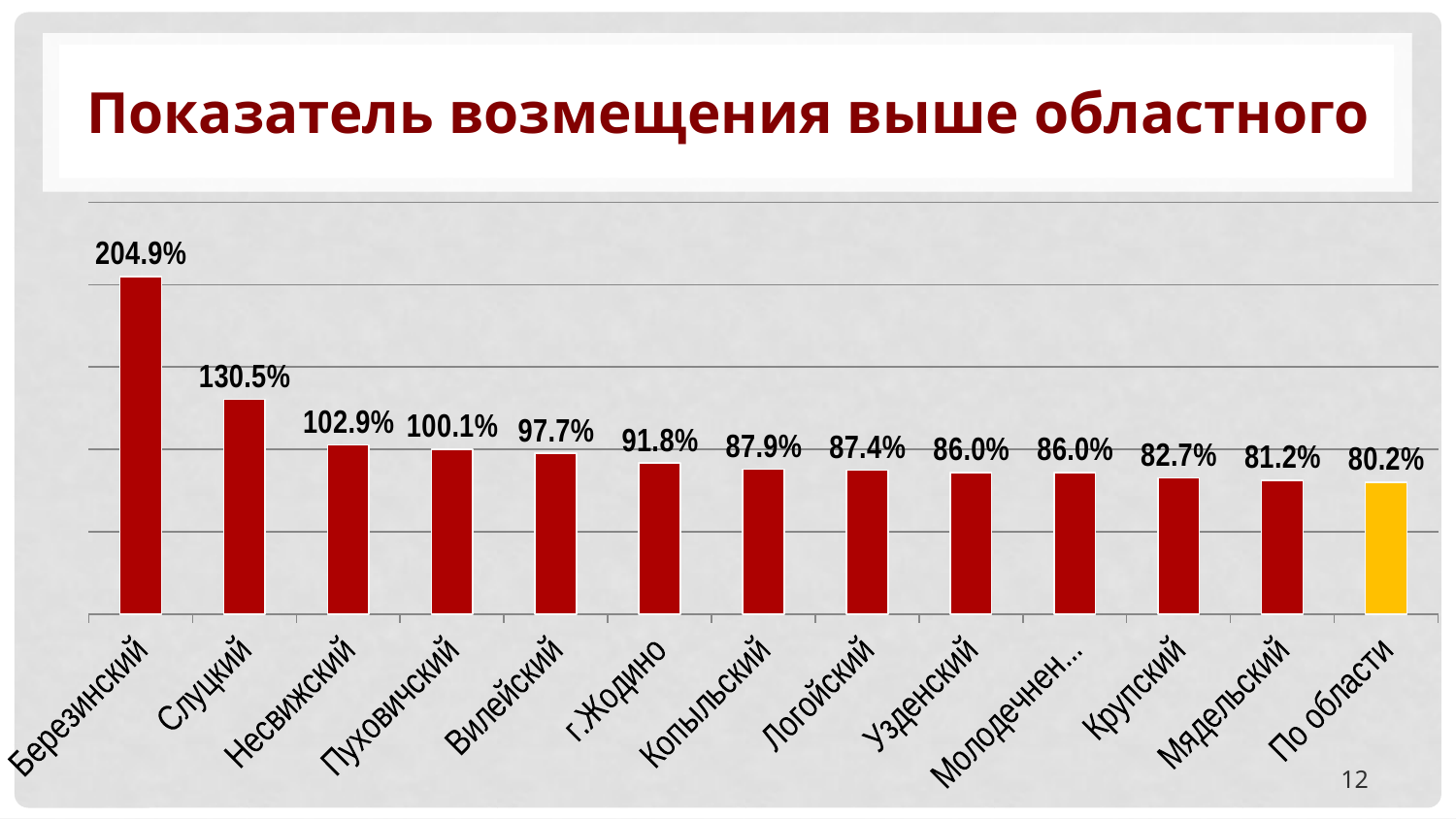
Which category has the highest value? Березинский What is the difference between the values for Березинский and Слуцкий? 74.4% What kind of chart is shown on the slide? Bar chart How many bars are shown in the chart? 13 Which category has the lowest value? По области What is the value shown for По области? 80.2% What is the value for Березинский? 204.9% What is the value for Слуцкий? 130.5% Which bar is coloured differently (yellow) from the others? По области What is the difference between the values for Несвижский and По области? 22.7% Which is larger, the value for Вилейский or the value for г.Жодино? Вилейский What is the value for Копыльский? 87.9%